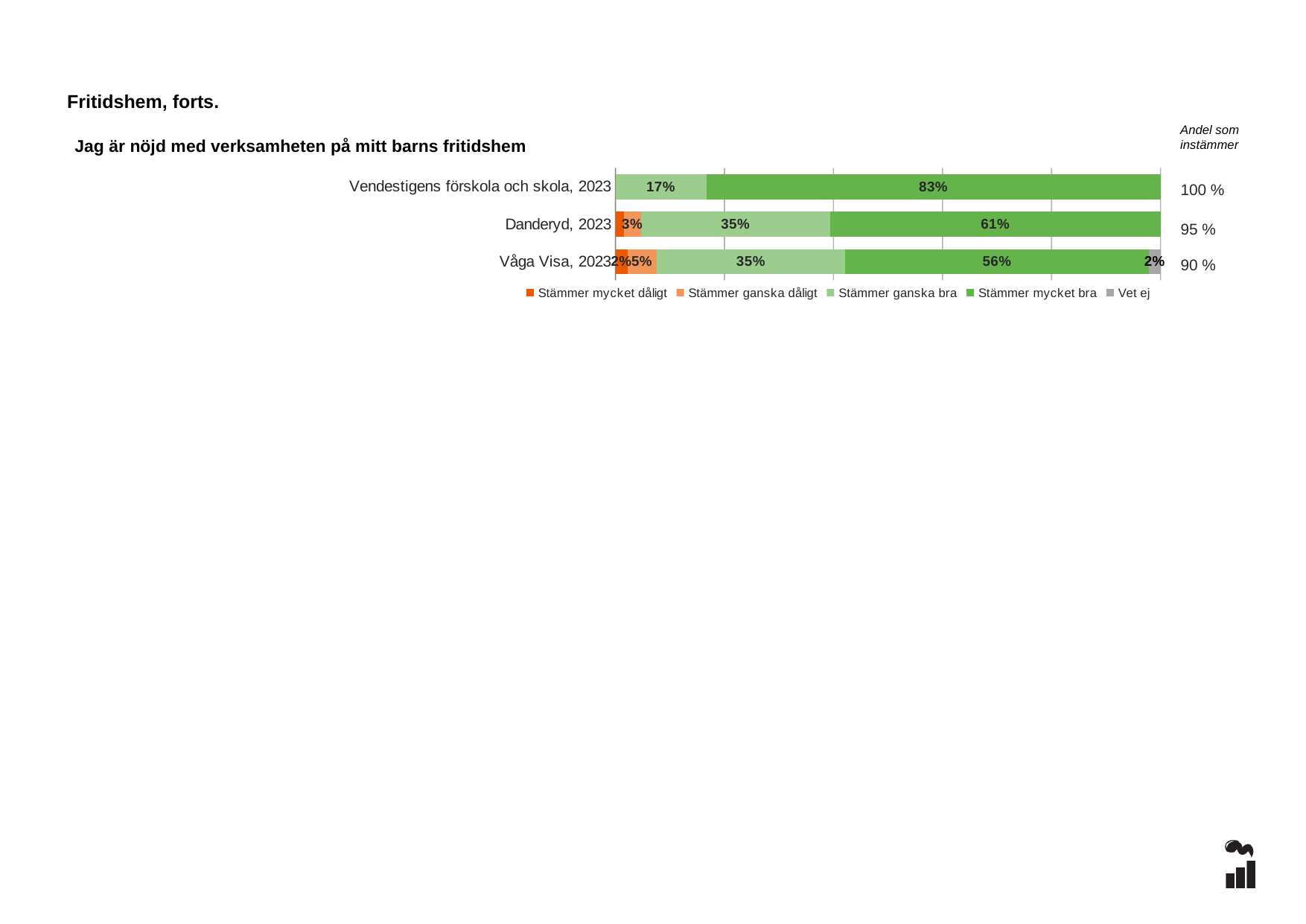
What kind of chart is shown on the slide? stacked bar chart How many series does the legend list? 5 What is the 'Andel som instämmer' value shown for Danderyd, 2023? 95 % What is the value of 'Stämmer ganska bra' for Vendestigens förskola och skola, 2023? 17% What is the value of 'Stämmer mycket bra' for Våga Visa, 2023? 56% How many categories (bars) are shown in the chart? 3 Which category has the highest value for 'Stämmer mycket bra'? Vendestigens förskola och skola, 2023 What is the value of 'Stämmer mycket bra' for Vendestigens förskola och skola, 2023? 83% What is the value of 'Stämmer mycket bra' for Danderyd, 2023? 61% What is the difference between the 'Stämmer mycket bra' values for Danderyd, 2023 and Våga Visa, 2023? 5% What is the value of 'Stämmer ganska bra' for Våga Visa, 2023? 35% What is the title of the chart? Jag är nöjd med verksamheten på mitt barns fritidshem